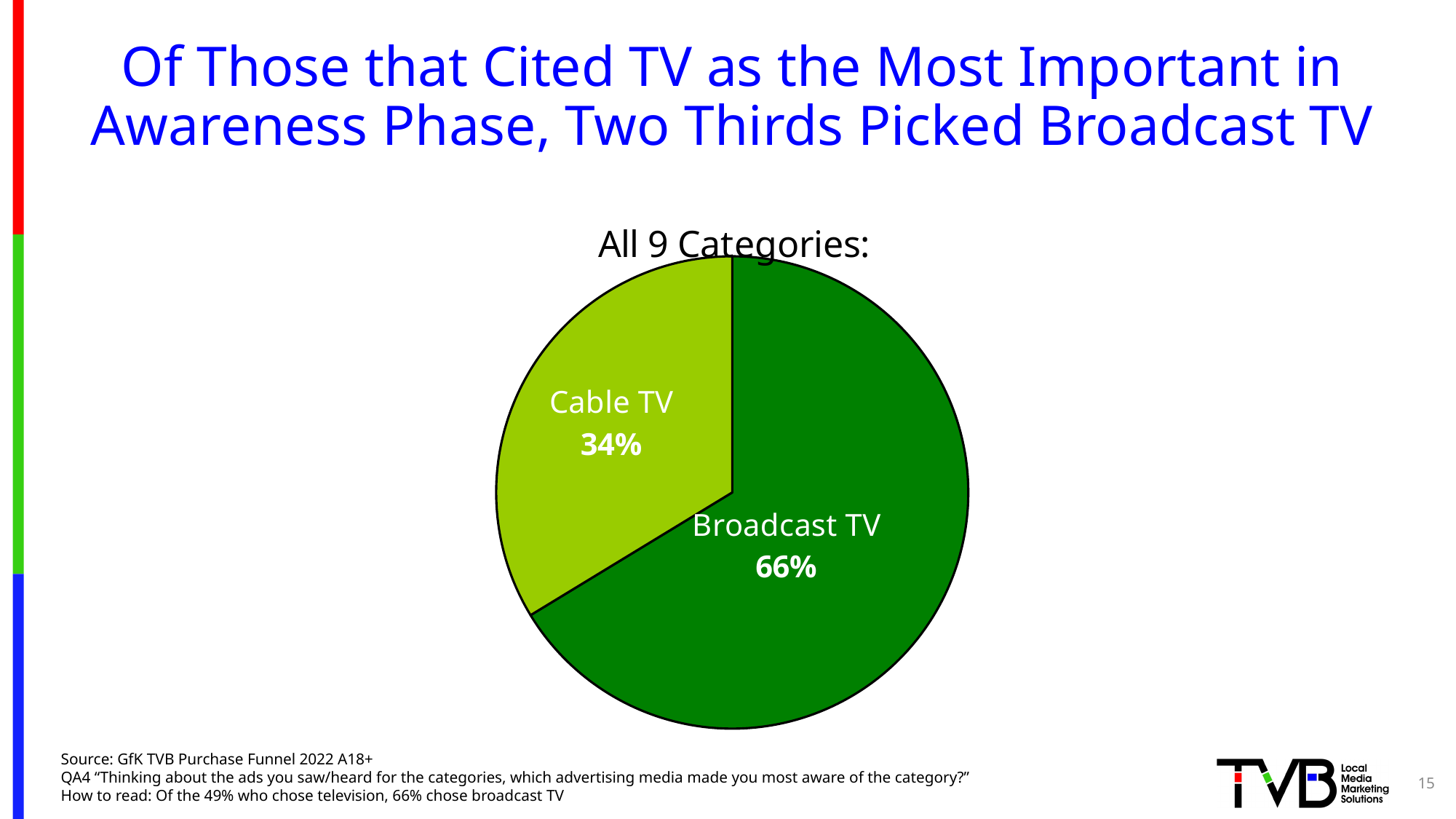
What share of the pie does Cable TV hold? 34% What share of the pie does Broadcast TV hold? 66% What is the difference in percentage points between the Broadcast TV and Cable TV slices? 32 Which slice is shown in the darker green colour? Broadcast TV What is the title of the chart? All 9 Categories: Which slice of the pie is the smallest? Cable TV How many slices does the pie chart have? 2 Which is larger, the Cable TV slice or the Broadcast TV slice? Broadcast TV What kind of chart is shown on the slide? Pie chart Which slice of the pie is the largest? Broadcast TV